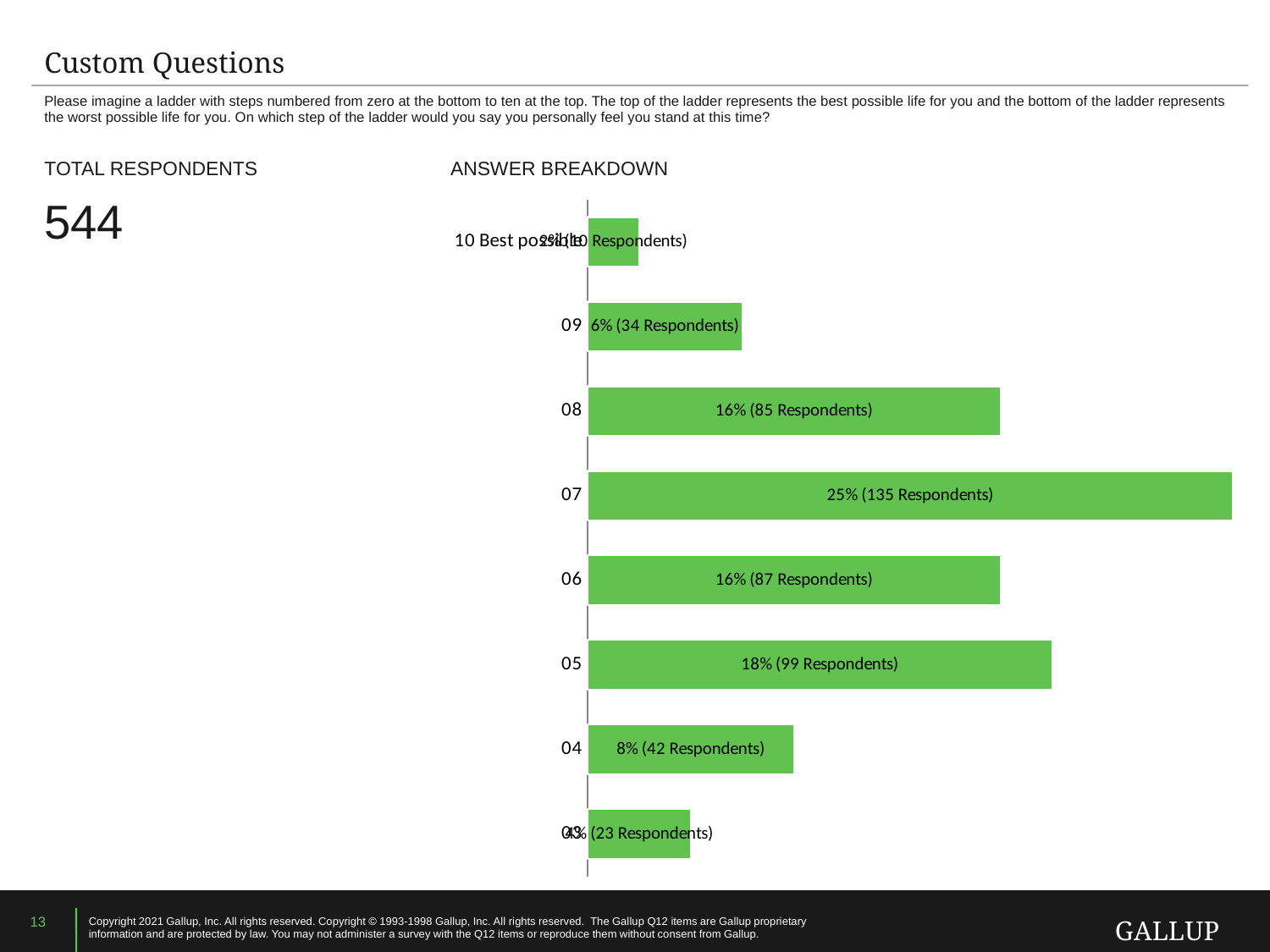
Which category has the shortest bar? 10 Best possible How many more respondents chose step 07 than step 08? 50 What is the data label shown for step 09? 6% (34 Respondents) What kind of chart is shown under ANSWER BREAKDOWN? bar chart How many bars are plotted in the chart? 8 What percentage of respondents chose step 07? 25% How many respondents chose step 05? 99 What colour are the bars in the chart? green Which has a larger share of respondents, step 05 or step 06? 05 How many respondents chose step 04? 42 Which step has the highest share of respondents? 07 What is the difference in respondents between step 06 and step 08? 2